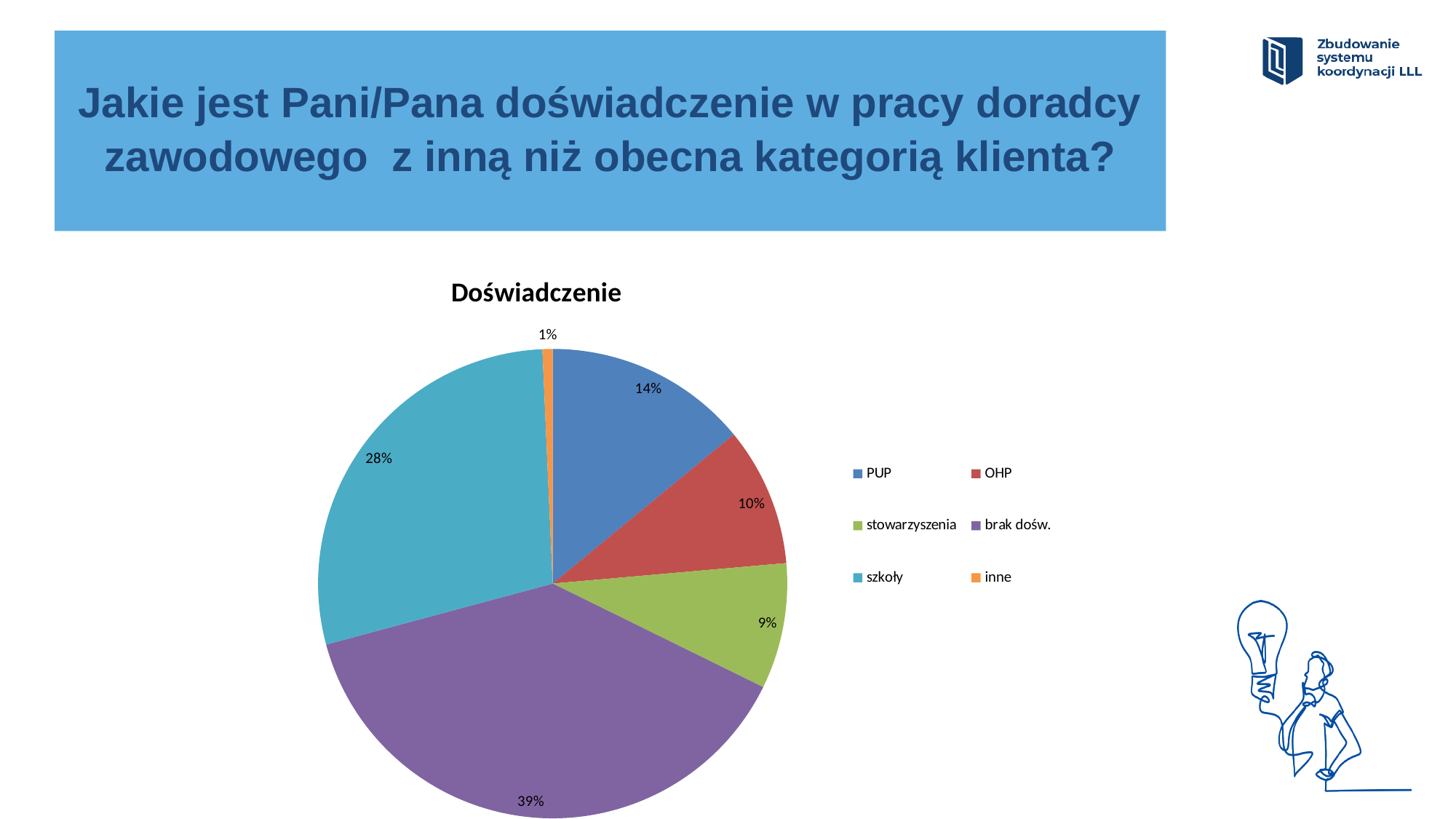
Which is larger, the 'OHP' slice or the 'stowarzyszenia' slice? OHP What is the value shown for 'PUP'? 14% Which category has the largest slice of the pie? brak dośw. What is the value shown for 'szkoły'? 28% What is the value shown for 'OHP'? 10% What kind of chart is shown on the slide? pie chart What is the difference between the 'szkoły' and 'PUP' shares? 14% What share of the pie does the 'brak dośw.' slice represent? 39% What is the title of the chart? Doświadczenie What is the value shown for 'stowarzyszenia'? 9% How many categories does the legend list? 6 Which category has the smallest slice of the pie? inne